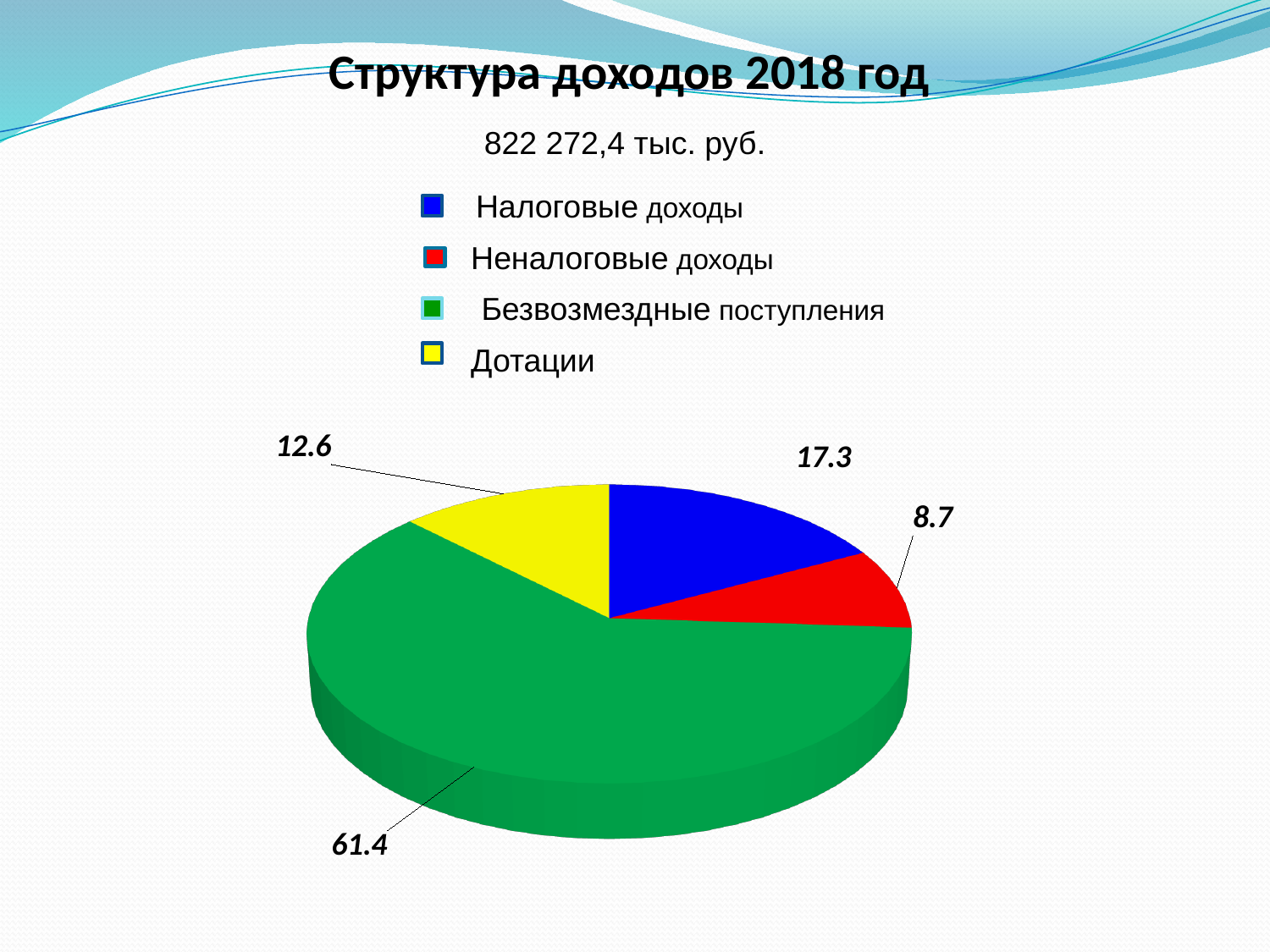
How many slices does the pie chart have? 4 What kind of chart is shown on the slide? pie chart Which category has the smallest slice of the pie? Неналоговые доходы What colour is the slice for Дотации? yellow What is the difference between the values for Налоговые доходы and Неналоговые доходы? 8.6 Which category has the largest slice of the pie? Безвозмездные поступления What is the value for Налоговые доходы? 17.3 What is the title of the slide's chart? Структура доходов 2018 год What is the value for Неналоговые доходы? 8.7 What is the value for Безвозмездные поступления? 61.4 Which is larger, the value for Дотации or the value for Неналоговые доходы? Дотации What is the value for Дотации? 12.6